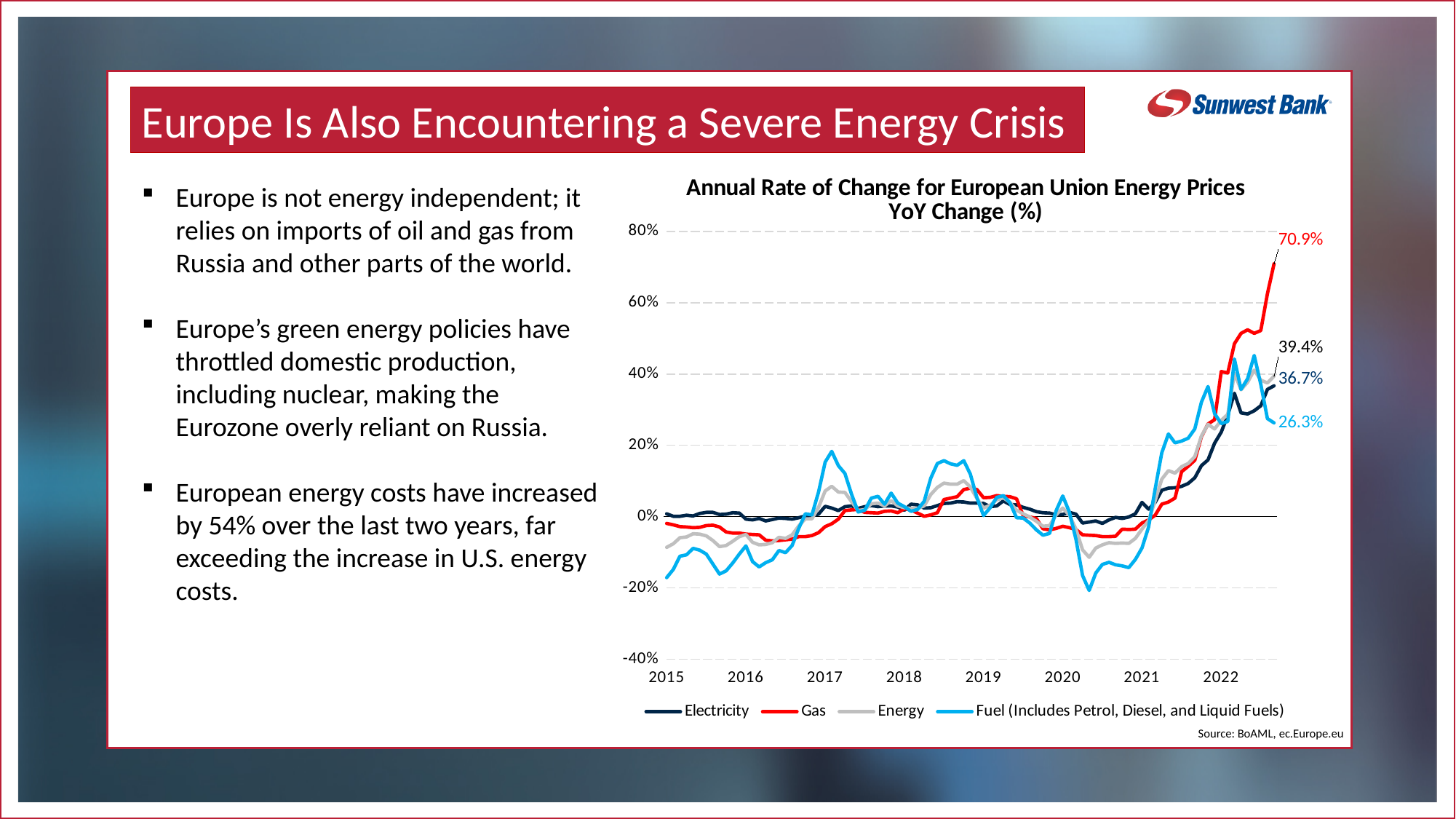
What kind of chart is shown on the slide? line chart What is the difference between the latest labelled Gas value and the latest labelled Fuel value? 44.6% What is the latest labelled value for the Electricity series? 36.7% Which series has the highest value at the end of the chart? Gas What is the latest labelled value for the Fuel (Includes Petrol, Diesel, and Liquid Fuels) series? 26.3% At the end of the chart, which is larger: the Gas value or the Electricity value? Gas What is the title of the chart? Annual Rate of Change for European Union Energy Prices YoY Change (%) Does the Gas series rise or fall between 2021 and 2022? rise Is the lowest point of the Fuel series around 2020 greater or less than 0%? less How many series does the legend list? 4 What is the latest labelled value for the Gas series? 70.9% Which series has the lowest value at the end of the chart? Fuel (Includes Petrol, Diesel, and Liquid Fuels)